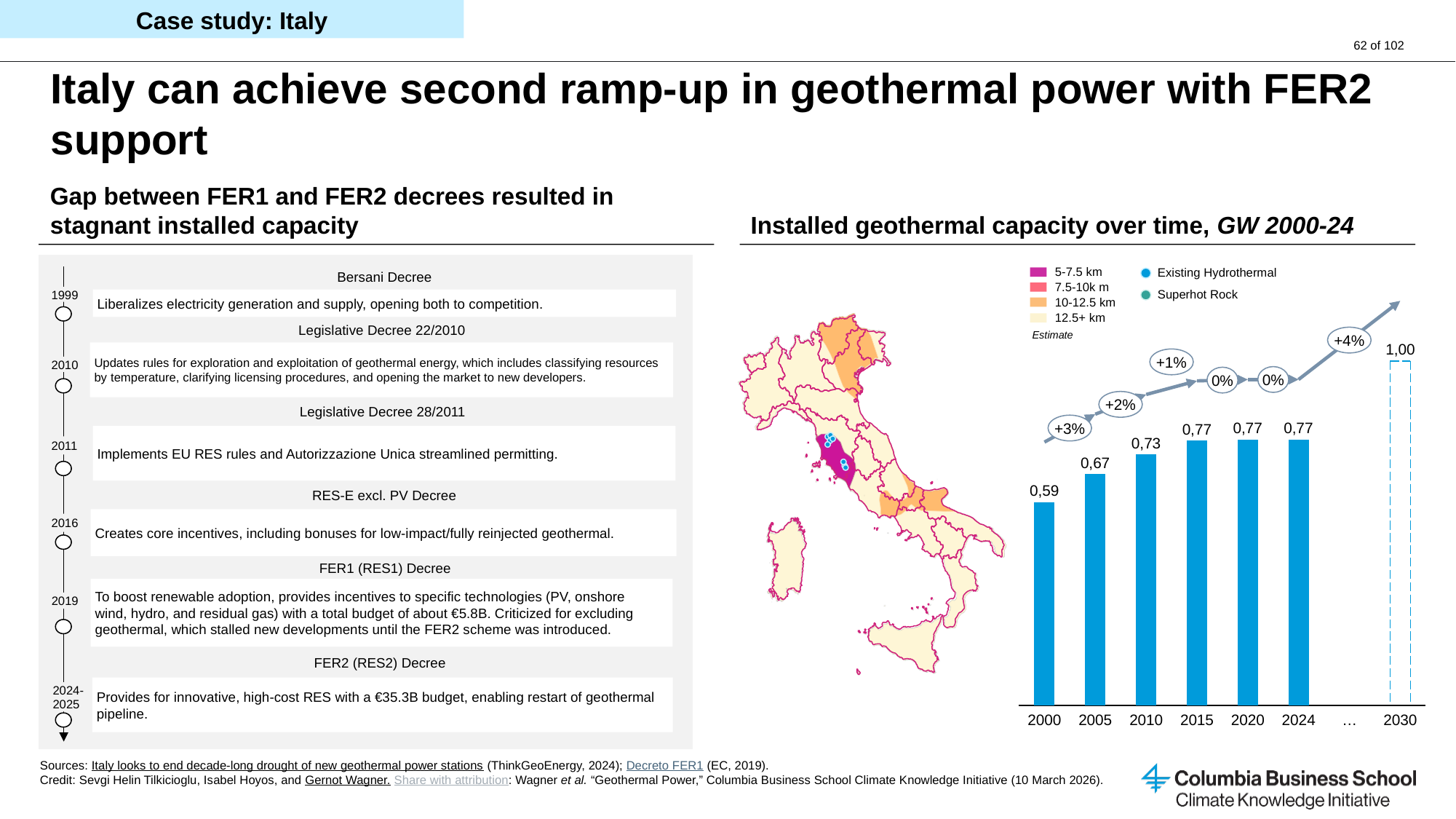
What is the installed geothermal capacity shown for 2024? 0,77 What is the difference between the 2030 estimate and the 2024 installed capacity? 0,23 What is the installed geothermal capacity shown for 2010? 0,73 What growth rate is annotated between 2024 and the 2030 estimate? +4% Is the installed capacity in 2010 larger or smaller than in 2005? larger Do the installed capacity values rise or fall from 2000 to 2030 along the x axis? rise What is the installed geothermal capacity shown for 2000? 0,59 What type of chart is used to show installed geothermal capacity over time? bar chart Which year has the lowest installed geothermal capacity in the chart? 2000 What is the installed geothermal capacity shown for 2005? 0,67 What is the difference between the installed capacity in 2024 and in 2000? 0,18 What is the estimated installed geothermal capacity shown for 2030? 1,00